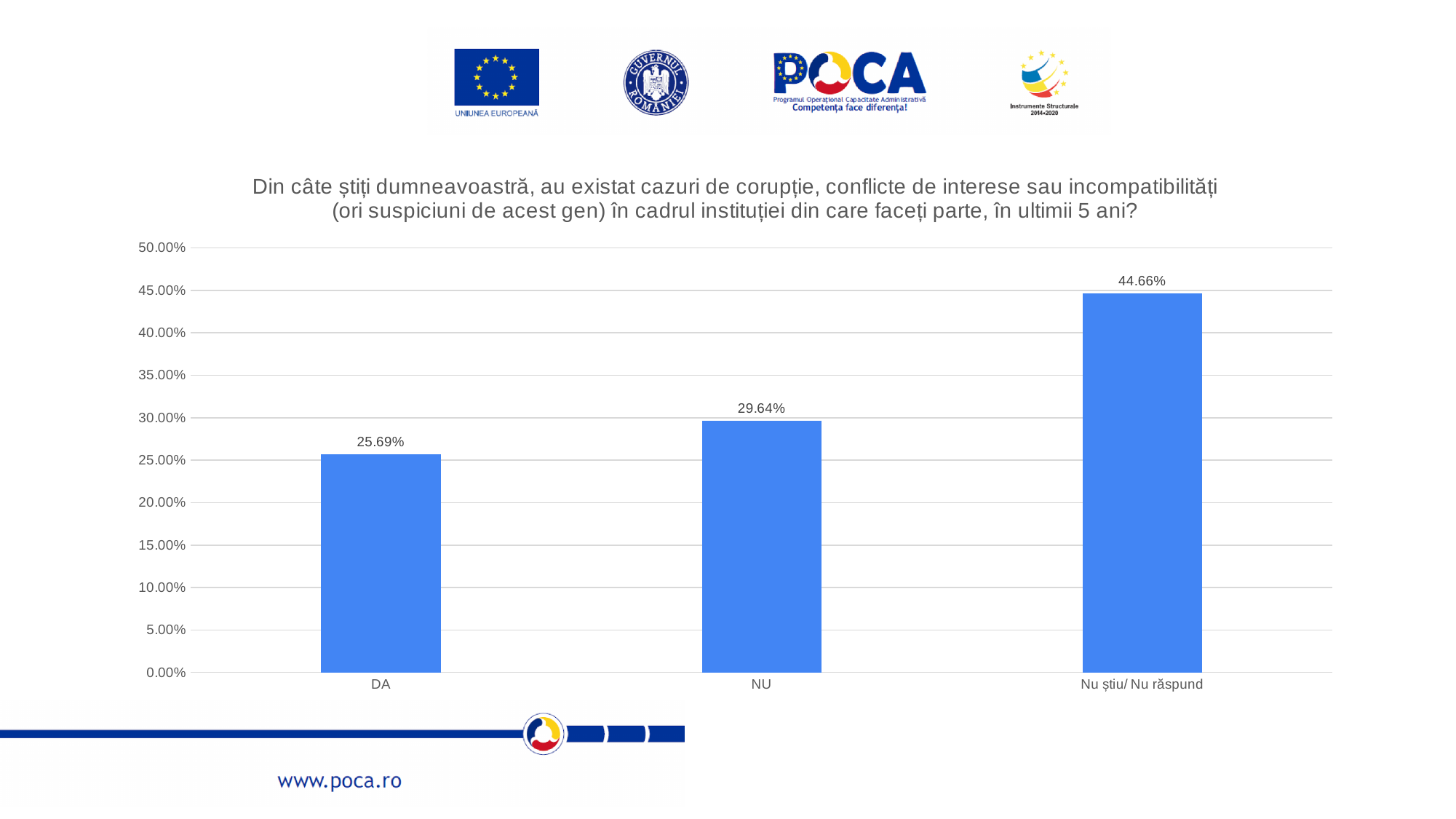
What is the difference between the values for NU and DA? 3.95% How many categories are shown on the x axis? 3 What is the highest value shown on the y axis? 50.00% Which category has the highest value? Nu știu/ Nu răspund What is the value for DA? 25.69% What kind of chart is shown on the slide? bar chart Which is larger, the value for DA or the value for NU? NU What is the value for NU? 29.64% Which category has the lowest value? DA Is the value for Nu știu/ Nu răspund greater or less than 40.00%? greater What is the value for Nu știu/ Nu răspund? 44.66% What is the difference between the values for Nu știu/ Nu răspund and NU? 15.02%